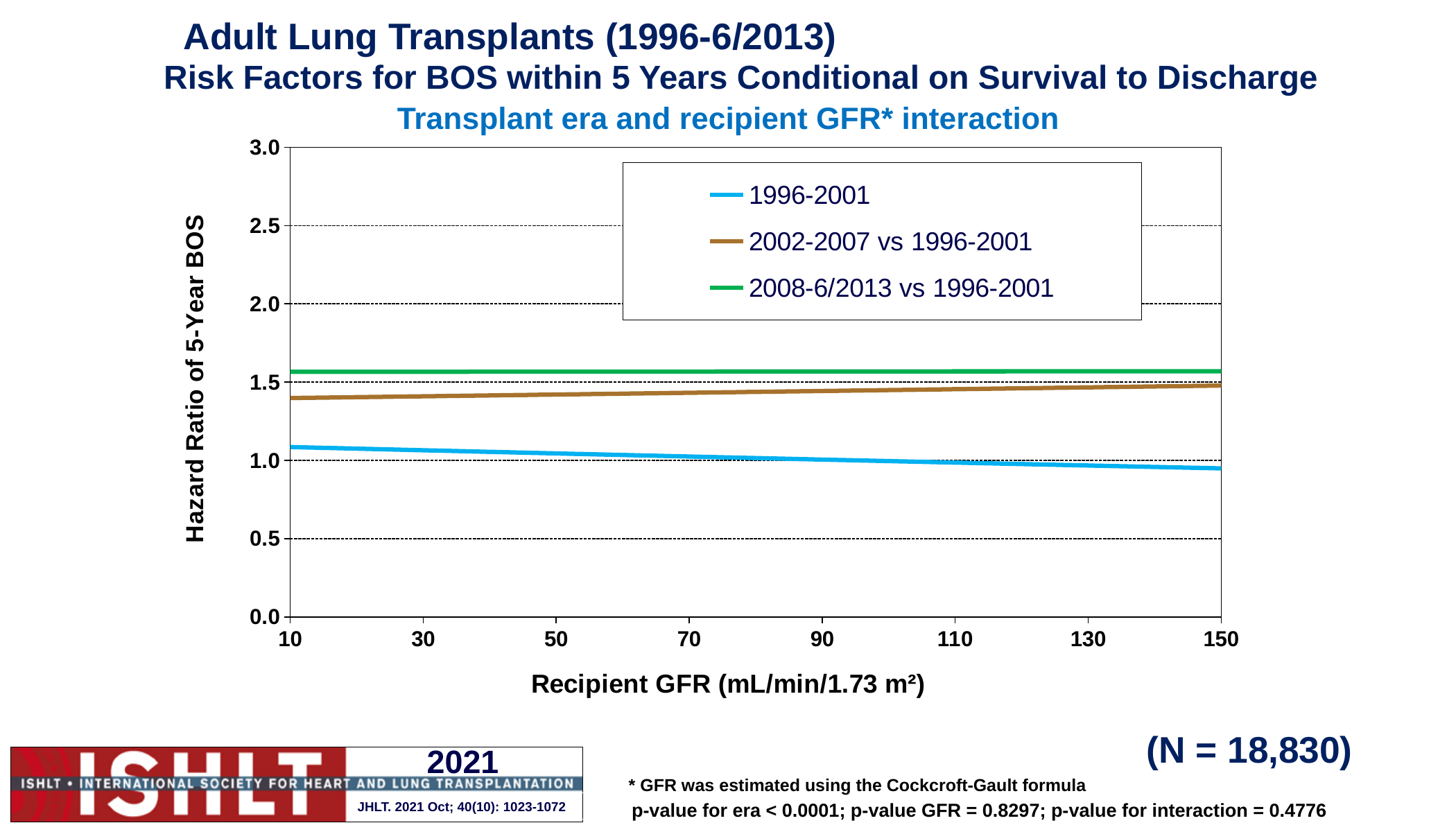
Is the hazard ratio for the 2002-2007 vs 1996-2001 series at a GFR of 10 greater or less than 1.5? less Does the hazard ratio for the 2002-2007 vs 1996-2001 series rise or fall as recipient GFR increases? rise What kind of chart is shown on the slide? line chart Is the hazard ratio for the 2008-6/2013 vs 1996-2001 series at a GFR of 70 greater or less than 1.5? greater What is the label of the y axis? Hazard Ratio of 5-Year BOS Does the hazard ratio for the 1996-2001 series rise or fall as recipient GFR increases? fall Which series has the highest hazard ratio across the GFR range? 2008-6/2013 vs 1996-2001 How many series does the legend list? 3 At a GFR of 130, which series has the larger hazard ratio: 2002-2007 vs 1996-2001 or 1996-2001? 2002-2007 vs 1996-2001 Is the hazard ratio for the 1996-2001 series at a GFR of 90 greater or less than 1.5? less What is the label of the x axis? Recipient GFR (mL/min/1.73 m²) Which series has the lowest hazard ratio across the GFR range? 1996-2001